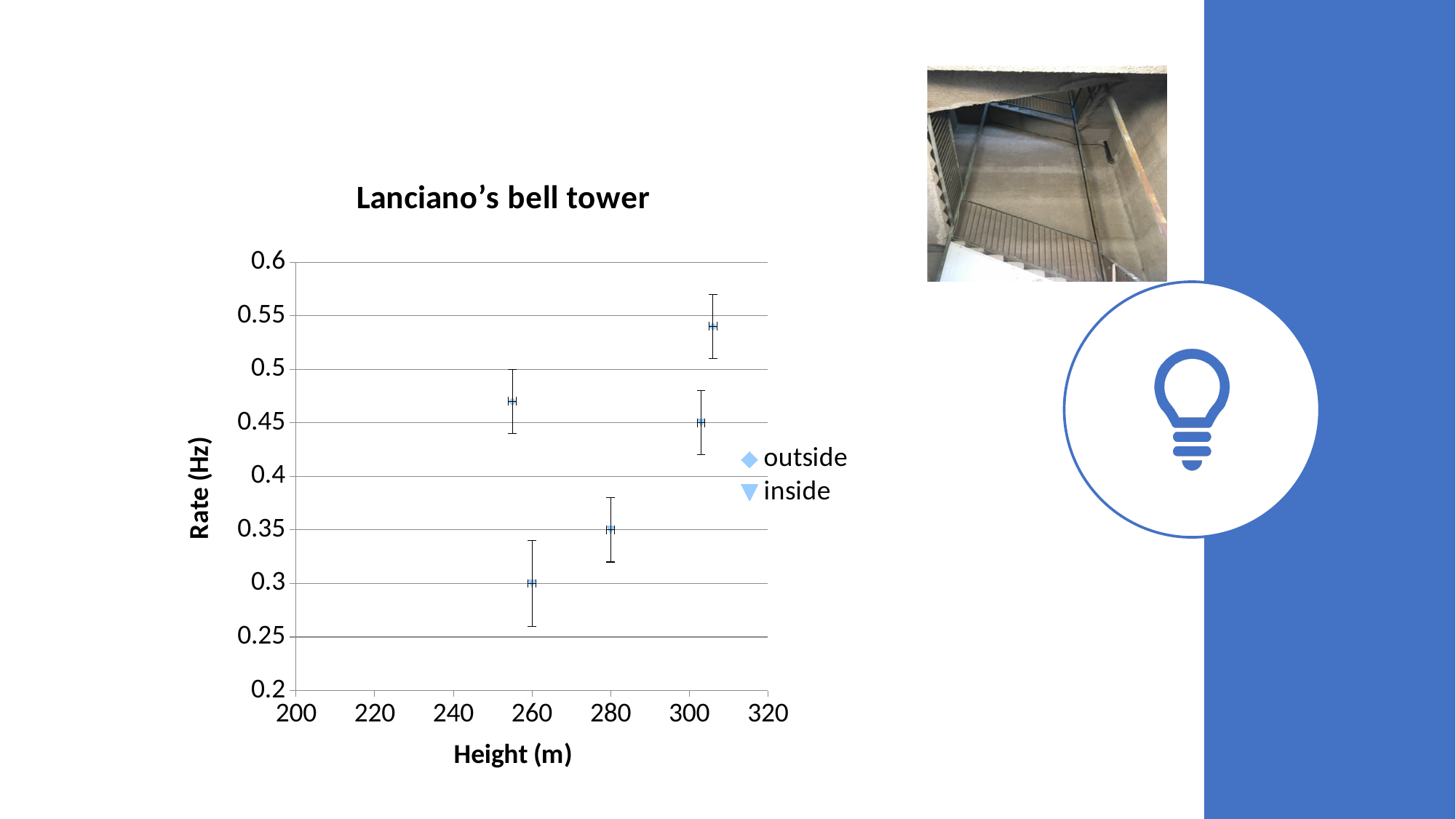
Is the rate of the point plotted at 260 m greater or less than 0.35 Hz? less What kind of chart is shown on the slide? scatter chart What is the title of the chart? Lanciano's bell tower What is the rate (Hz) of the point plotted at a height of 260 m? 0.3 What is the label of the y axis? Rate (Hz) What are the two series named in the legend? outside and inside How many data points are plotted on the chart? 5 What is the rate (Hz) of the point plotted at a height of 280 m? 0.35 Is the rate of the point plotted near 255 m greater or less than 0.4 Hz? greater How many series does the chart's legend list? 2 Which point has the higher rate: the one at 260 m or the one at 280 m? the one at 280 m